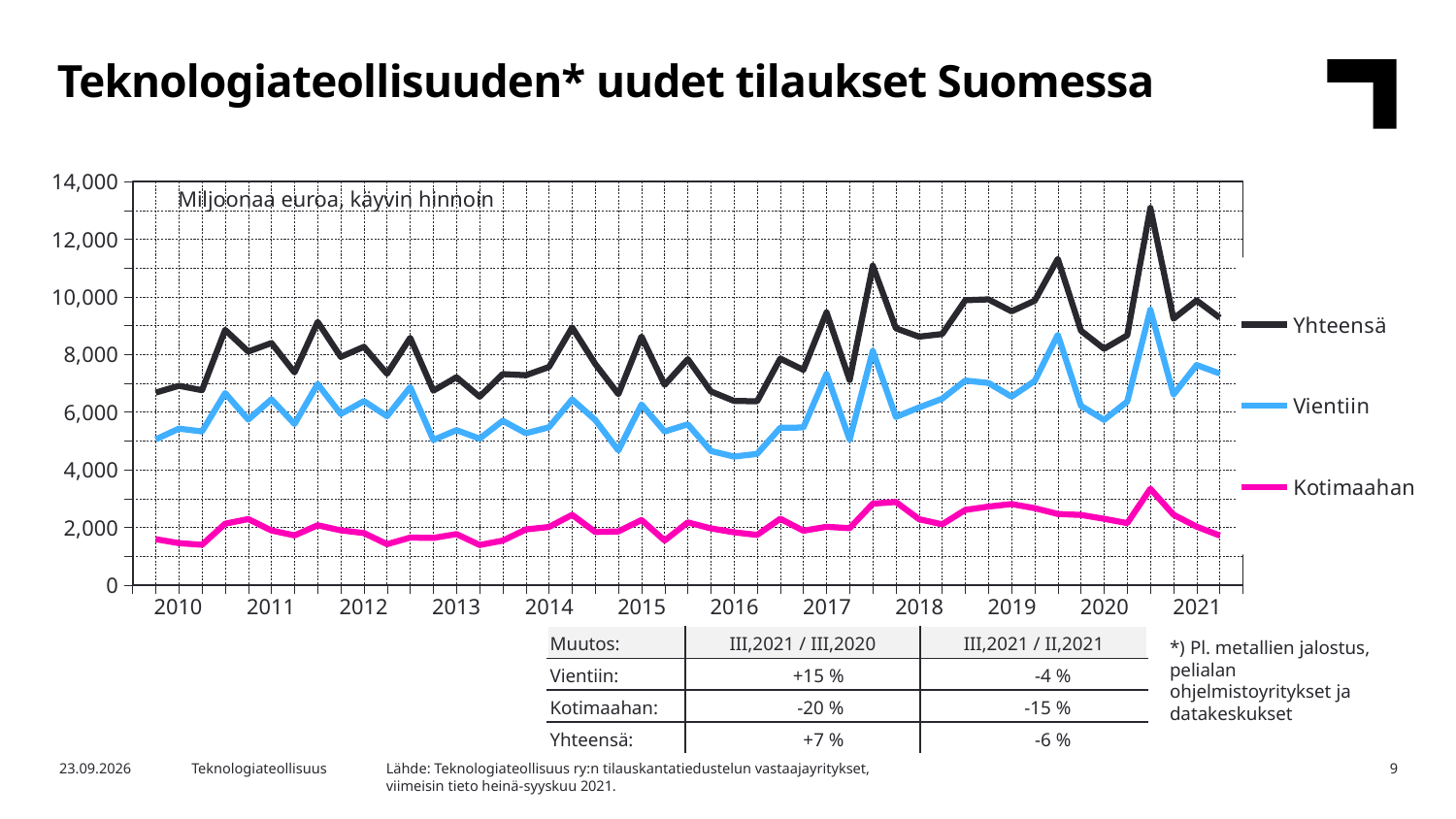
Which series has the lowest values throughout the chart? Kotimaahan Is the highest point of the Kotimaahan line greater or less than 4,000? less Which series has the highest values throughout the chart? Yhteensä How many years are labelled on the x axis of the chart? 12 Is the highest point of the Yhteensä line greater or less than 12,000? greater Which series is drawn in black in the chart? Yhteensä How many series does the chart legend list? 3 Is the highest point of the Vientiin line greater or less than 8,000? greater Which series is larger at the end of 2021, Vientiin or Kotimaahan? Vientiin What unit label is printed inside the chart area? Miljoonaa euroa, käyvin hinnoin Does the Kotimaahan line rise or fall from its 2020 peak to the end of 2021? fall What kind of chart is shown on the slide? line chart